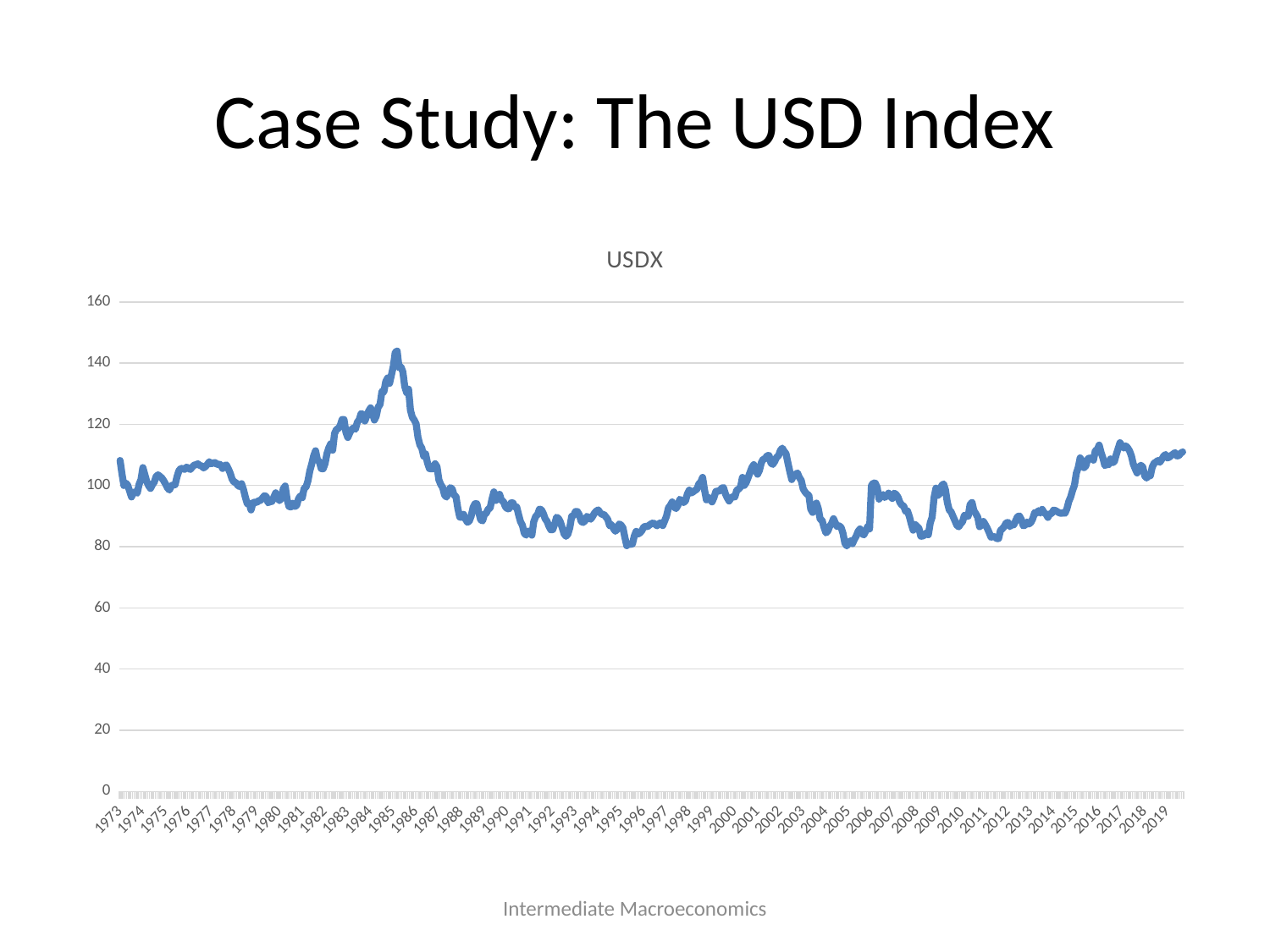
Is the USDX value in 1983 greater or less than 100? greater Does the USDX rise or fall between 1980 and 1985? rise What is the highest value shown on the vertical axis? 160 What kind of chart is shown on the slide? line chart Is the USDX value in 1995 greater or less than 100? less Does the USDX rise or fall between 1985 and 1988? fall What is the title of the chart? USDX Is the peak value of the USDX around 1985 greater or less than 120? greater Does the USDX rise or fall between 2002 and 2005? fall Which is higher, the USDX value in 1985 or in 1995? 1985 In which year does the USDX line reach its highest point? 1985